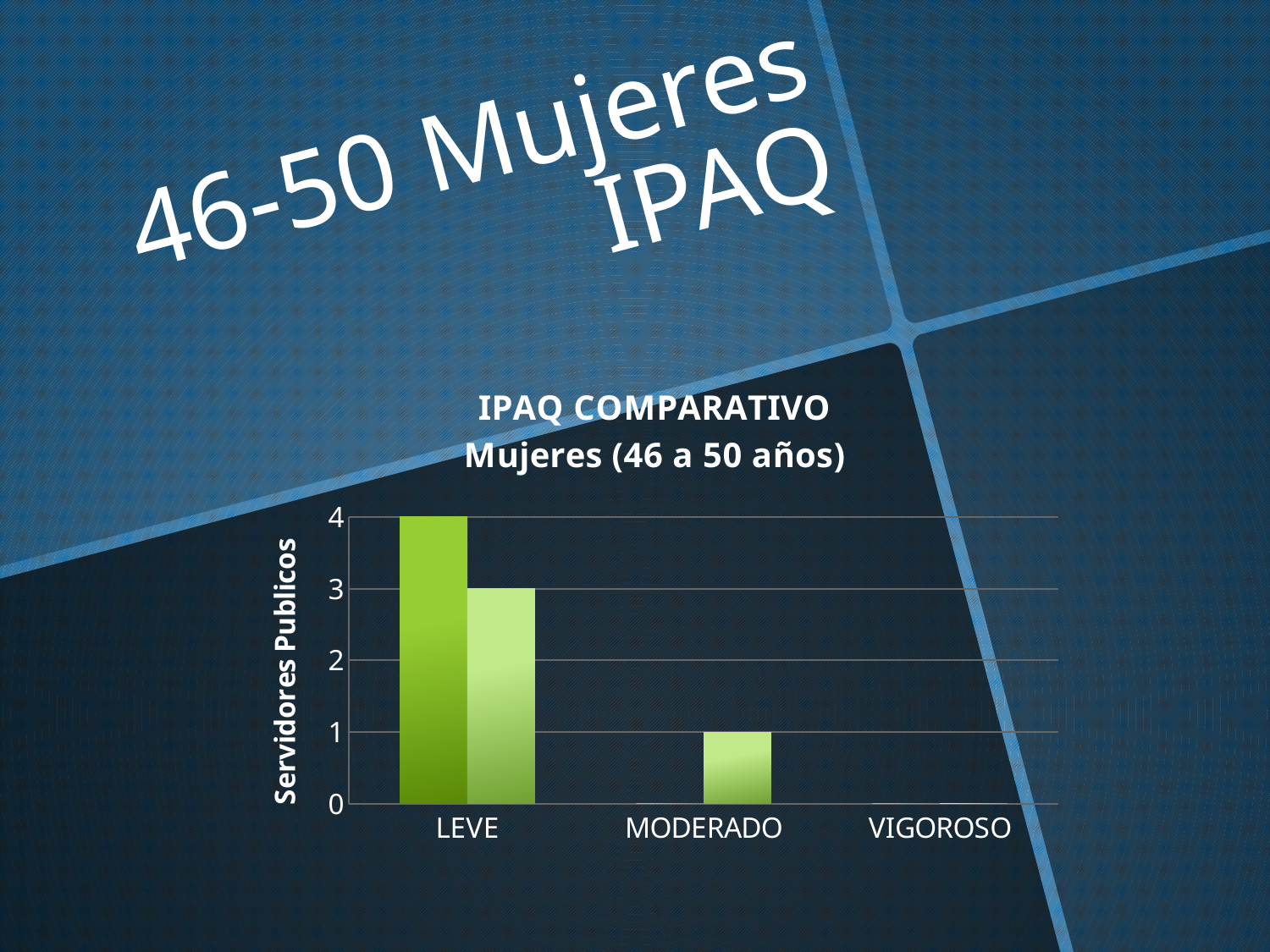
Which category shows no visible bars at all? VIGOROSO Which category has the tallest bar in the chart? LEVE How many categories are shown on the x axis of the chart? 3 Is the value of the darker green bar for LEVE greater or less than 2? greater What is the difference between the darker green bar and the lighter green bar for LEVE? 1 What is the value of the lighter green bar for MODERADO? 1 What kind of chart is shown on the slide? bar chart What is the title of the vertical axis of the chart? Servidores Publicos Which is larger: the lighter green bar for LEVE or the lighter green bar for MODERADO? LEVE What is the value of the lighter green bar for LEVE? 3 What is the difference between the lighter green bar for LEVE and the lighter green bar for MODERADO? 2 What is the value of the darker green bar for LEVE? 4